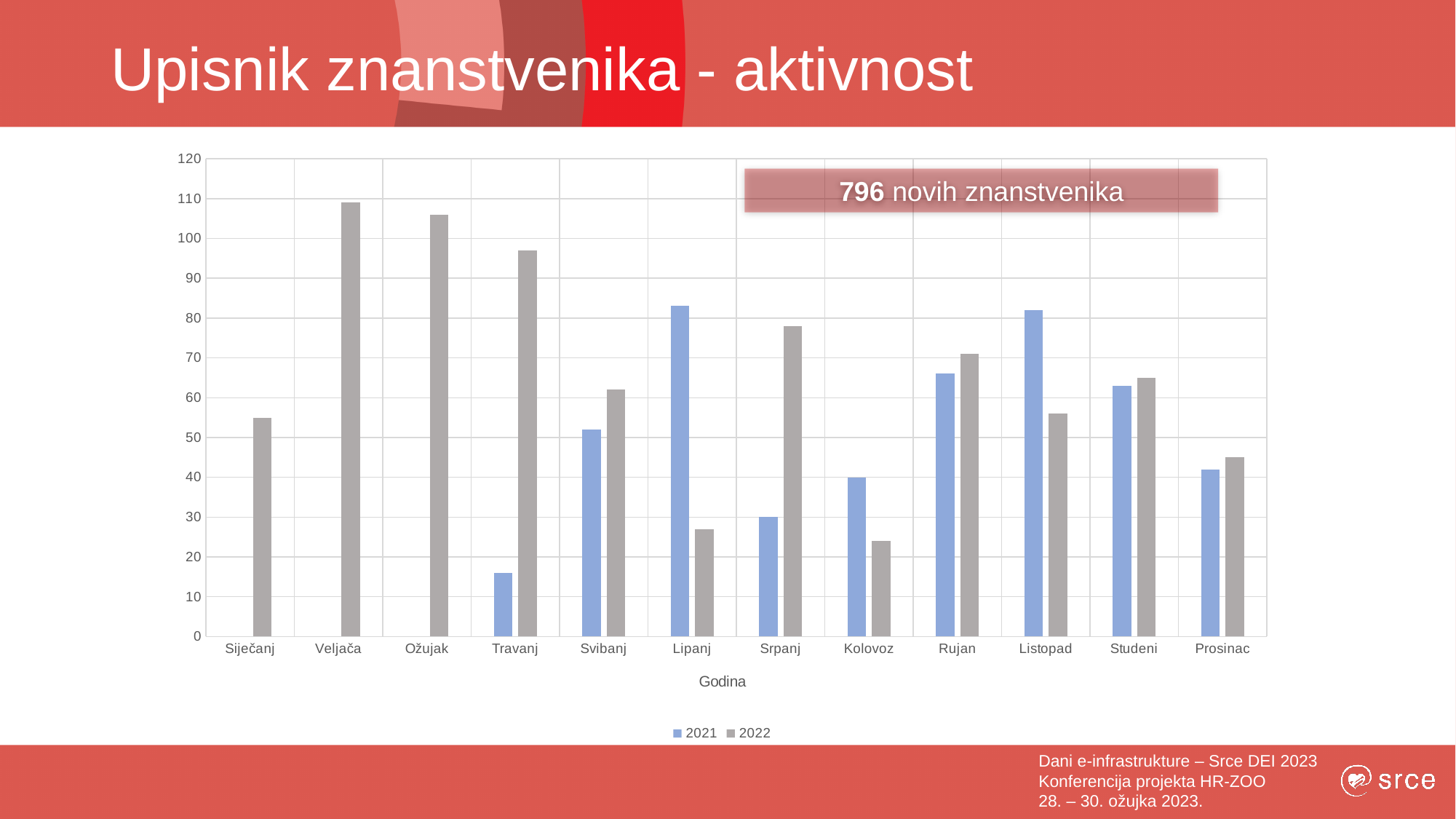
For Travanj, which series has the larger value, 2021 or 2022? 2022 Is the 2021 value for Travanj greater or less than 20? less What is the title of the x axis? Godina What number is highlighted in the callout box on the chart? 796 Is the 2022 value for Veljača greater or less than 100? greater Is the 2022 value for Kolovoz greater or less than 30? less What kind of chart is shown on the slide? bar chart For Lipanj, which series has the larger value, 2021 or 2022? 2021 How many series does the legend list? 2 Which month has the lowest value for the 2021 series? Travanj How many months (categories) are shown on the x axis? 12